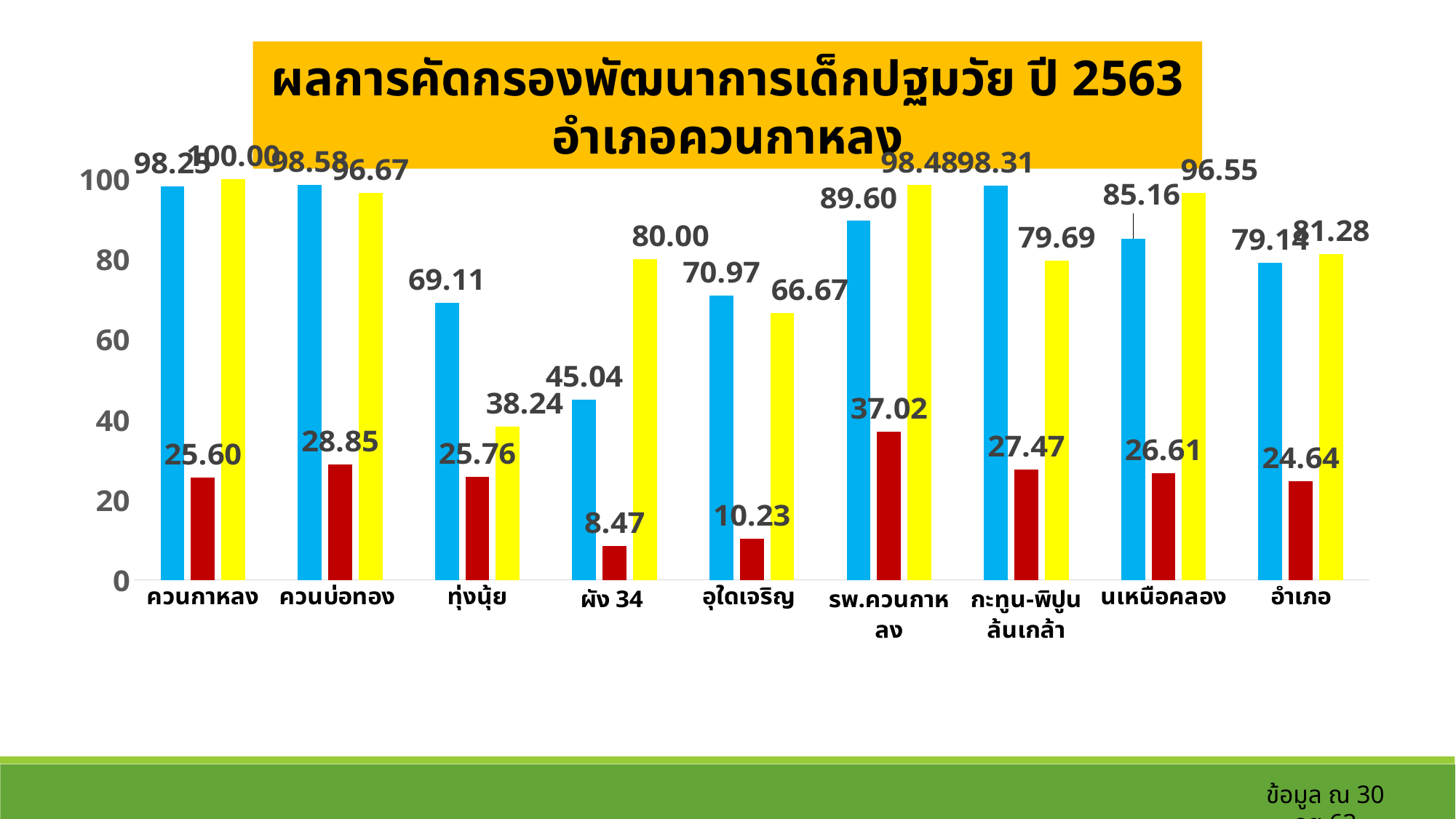
Which category has the highest yellow bar? ควนกาหลง What type of chart is shown on the slide? bar chart Which category has the lowest blue bar? ผัง 34 What is the title of the chart? ผลการคัดกรองพัฒนาการเด็กปฐมวัย ปี 2563 อำเภอควนกาหลง How many categories are shown on the x axis? 9 What is the value of the yellow bar for ทุ่งนุ้ย? 38.24 What is the difference between the yellow bar and the blue bar for ผัง 34? 34.96 Which is larger for อุใดเจริญ, the blue bar or the yellow bar? the blue bar What is the value of the blue bar for นเหนือคลอง? 85.16 Which category has the highest red bar? รพ.ควนกาหลง What is the value of the red bar for ผัง 34? 8.47 What is the difference between the red bars for รพ.ควนกาหลง and ผัง 34? 28.55